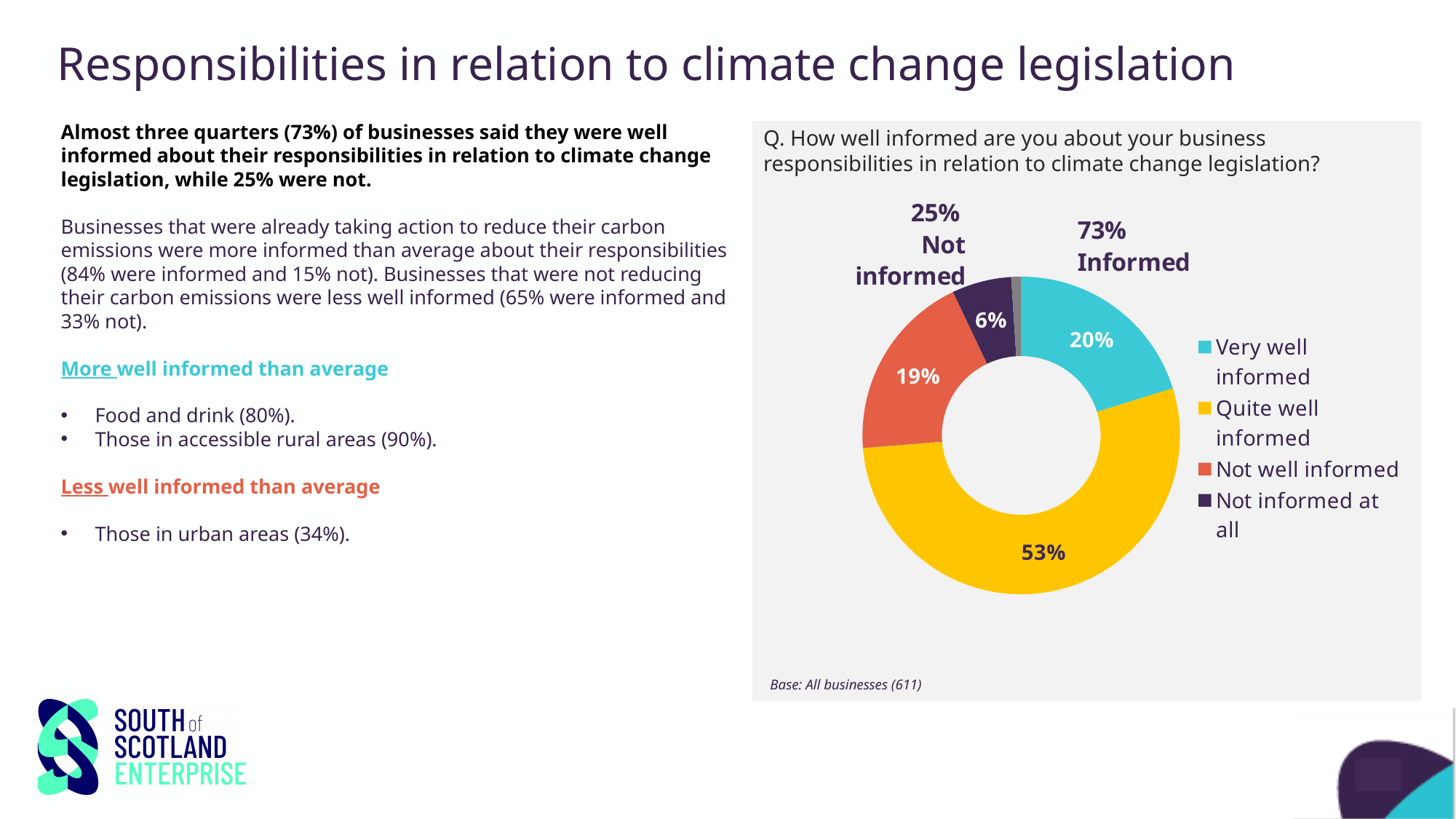
What kind of chart is shown on the slide? Doughnut (pie) chart Which is larger: the share for 'Very well informed' or the share for 'Not well informed'? Very well informed What is the difference in percentage points between 'Quite well informed' and 'Very well informed'? 33 What combined percentage is labelled as 'Informed' on the chart? 73% What percentage of businesses said they were 'Very well informed'? 20% What is the base (number of respondents) stated beneath the chart? All businesses (611) What percentage of businesses said they were 'Not informed at all'? 6% Which response category has the largest share of the chart? Quite well informed Which labelled response category has the smallest share of the chart? Not informed at all What percentage of businesses said they were 'Quite well informed'? 53% What percentage of businesses said they were 'Not well informed'? 19% How many entries does the chart legend list? 4